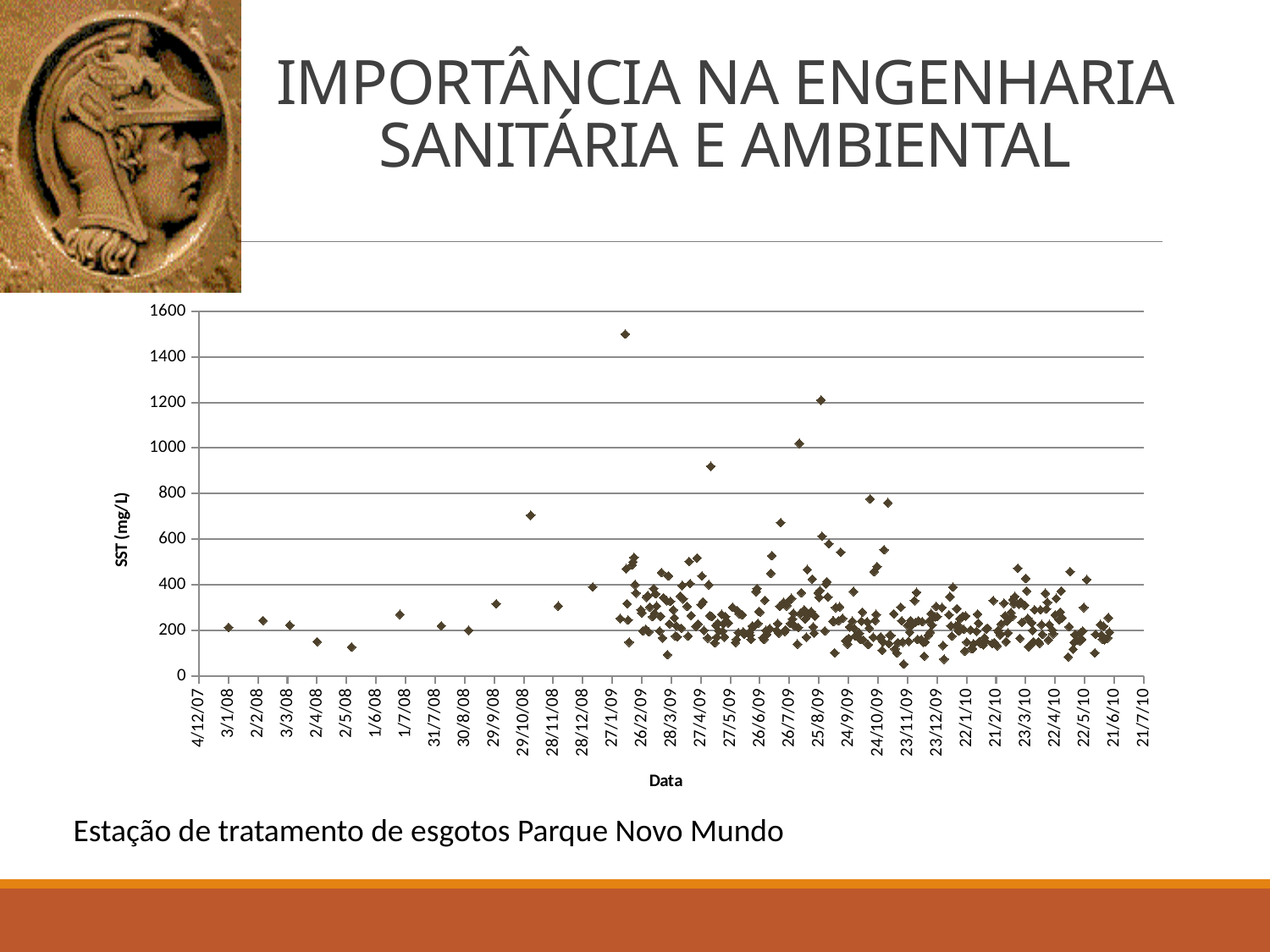
Is the value of the point near 2/5/08 greater or less than 200? less What kind of chart is shown on the slide? scatter chart What is the label of the vertical axis of the chart? SST (mg/L) How many points on the chart have a value above 1400? 1 Is the value of the highest point on the chart greater or less than 1400? greater Is the value of the isolated point near 29/10/08 greater or less than 600? greater What is the label of the horizontal axis of the chart? Data